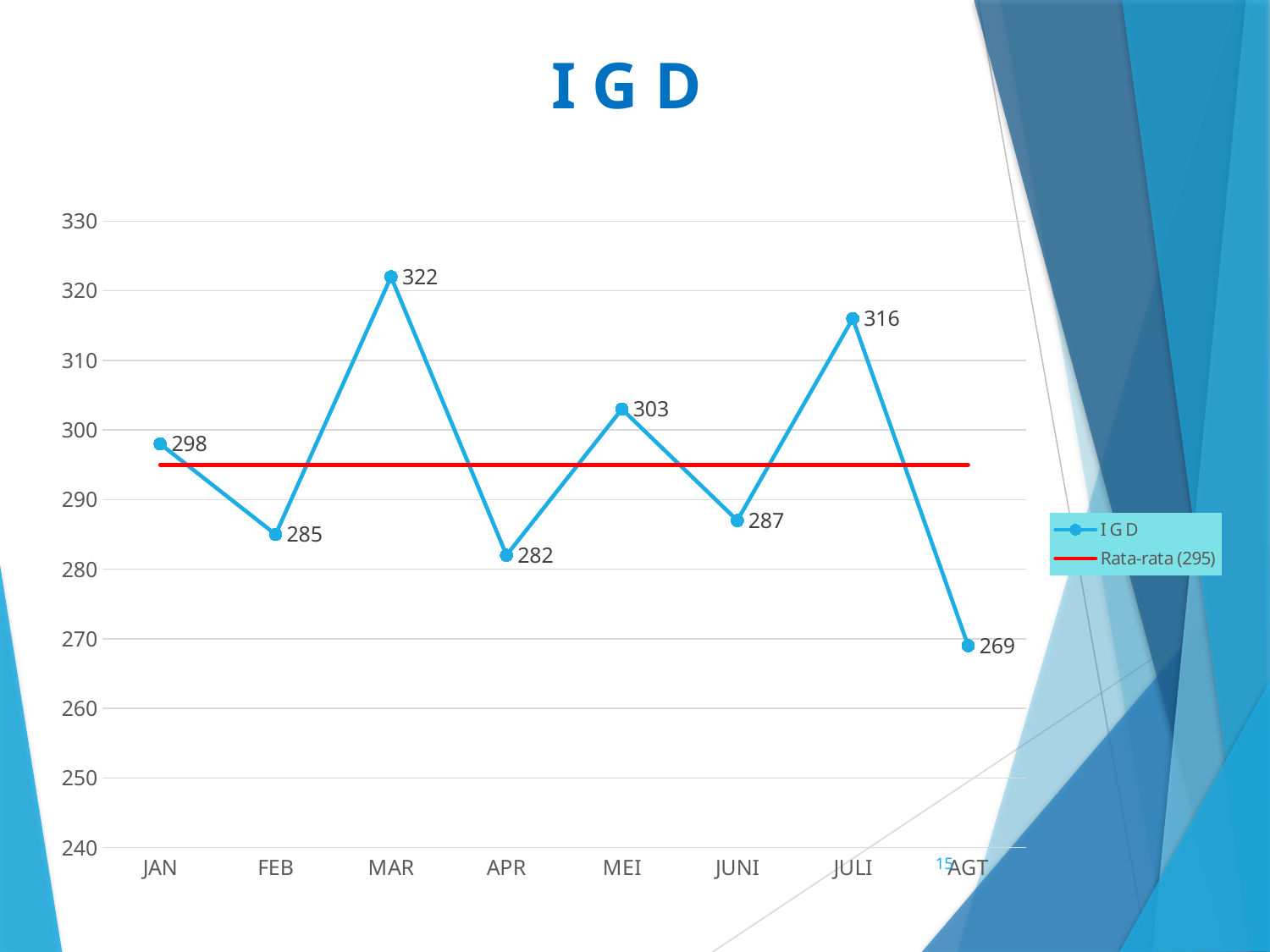
What value does the legend give for the Rata-rata line? 295 What is the I G D value for MAR? 322 Is the I G D value for JULI greater or less than 310? greater Which month has the highest I G D value? MAR What is the I G D value for AGT? 269 What is the difference between the I G D values for MAR and APR? 40 How many months are plotted on the x axis? 8 What kind of chart is shown? line chart How many series does the legend list? 2 Which is larger, the I G D value for JAN or for FEB? JAN Which month has the lowest I G D value? AGT What is the I G D value for MEI? 303